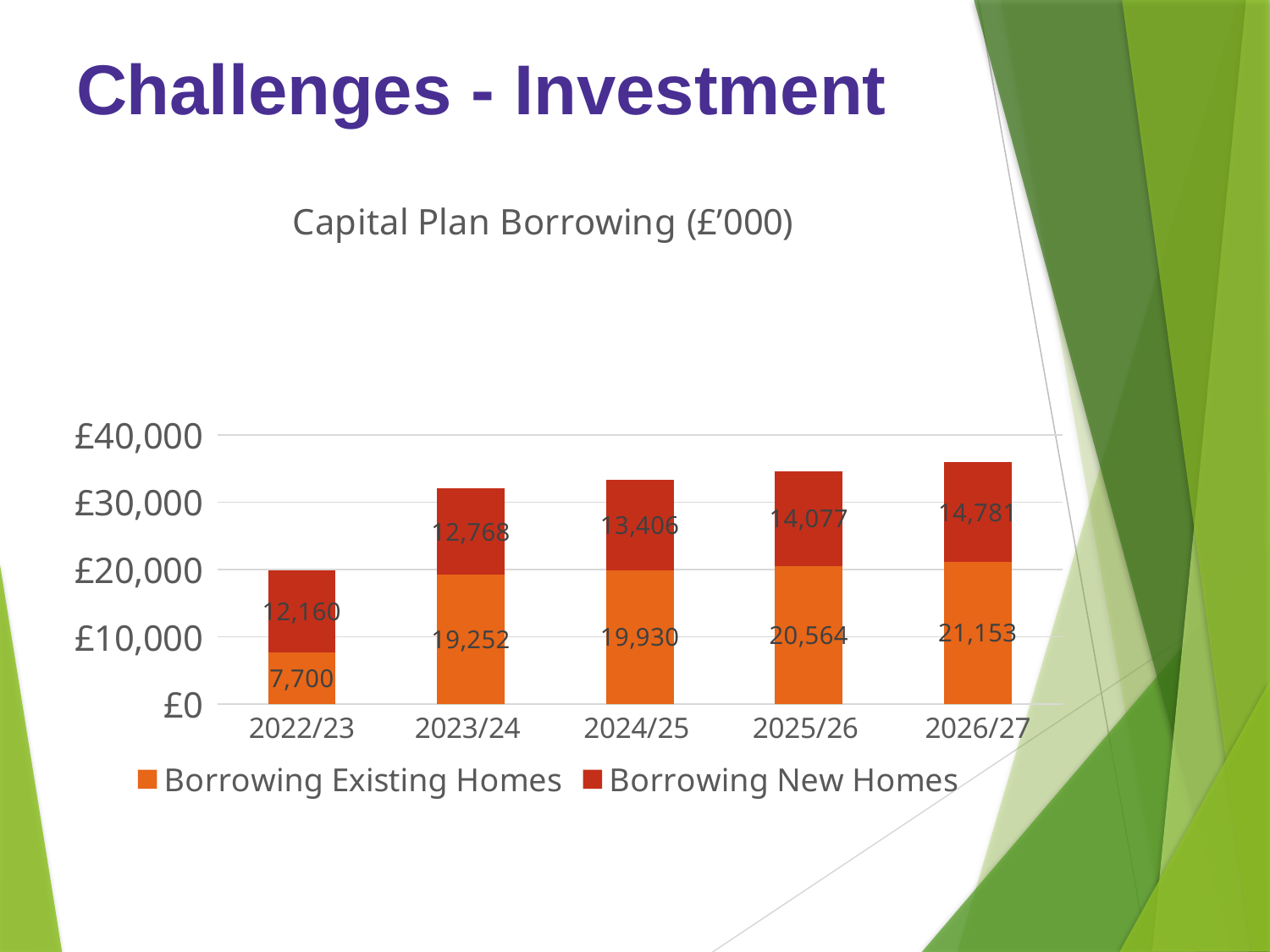
How many series does the legend list? 2 What is the difference between Borrowing Existing Homes in 2026/27 and in 2022/23? 13,453 Which is larger in 2023/24: Borrowing Existing Homes or Borrowing New Homes? Borrowing Existing Homes What is the value for Borrowing New Homes in 2026/27? 14,781 What is the total of the stacked bar for 2026/27? 35,934 What is the value for Borrowing Existing Homes in 2022/23? 7,700 What kind of chart is shown on the slide? Stacked bar chart How many years are shown on the x axis? 5 Which year has the highest value for Borrowing New Homes? 2026/27 Which year has the lowest value for Borrowing Existing Homes? 2022/23 What is the value for Borrowing Existing Homes in 2024/25? 19,930 What is the total of the stacked bar for 2022/23? 19,860